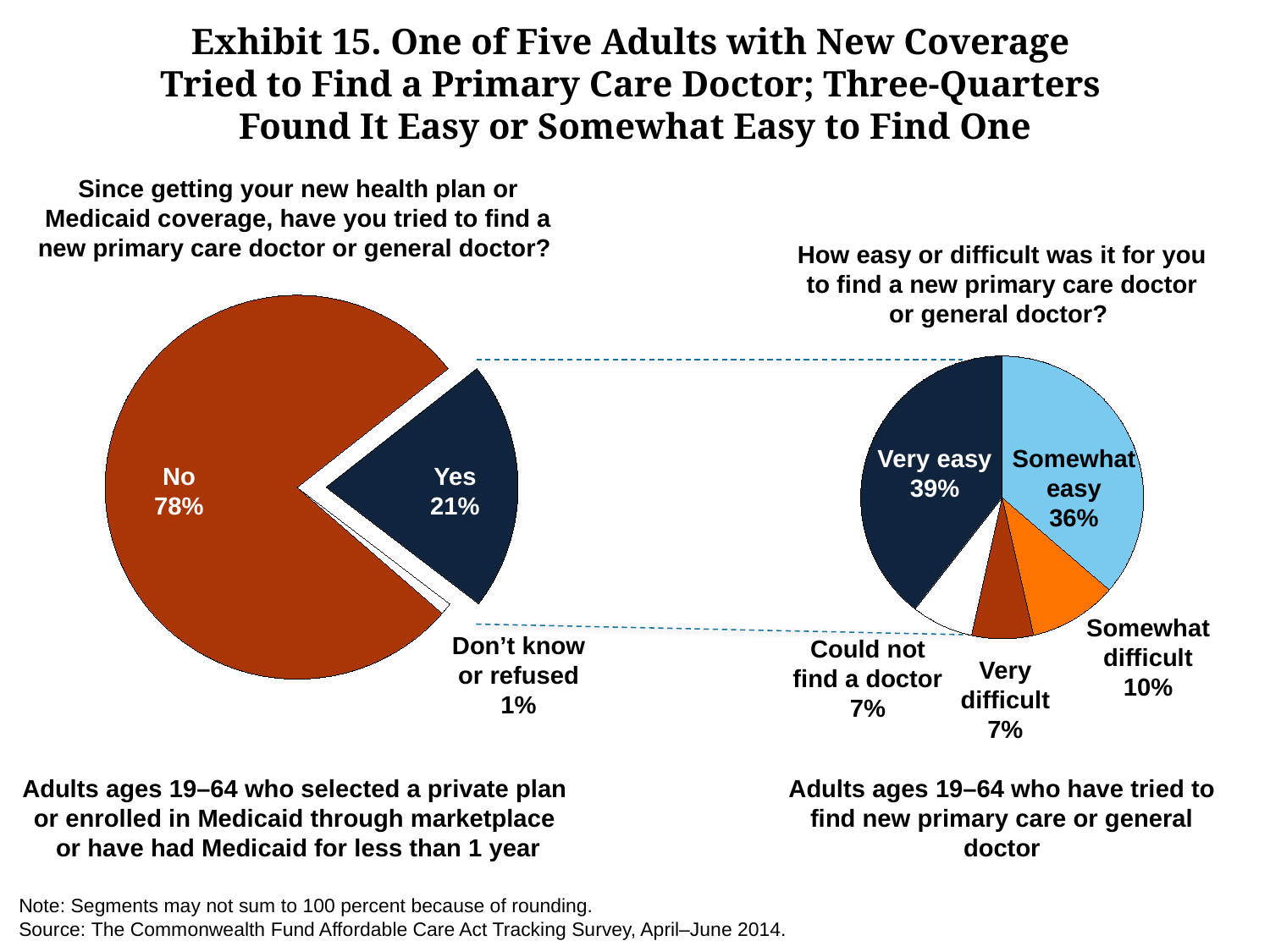
How many segments does the right pie chart have? 5 In the left pie chart, what percentage is labeled "Don't know or refused"? 1% In the right pie chart, which category has the largest share? Very easy In the right pie chart, what percentage found it "Somewhat difficult"? 10% In the right pie chart, what percentage could not find a doctor? 7% In the left pie chart, what percentage answered "Yes"? 21% What type of chart is used on the left side of the slide? Pie chart In the right pie chart, what percentage found it "Very easy" to find a new doctor? 39% In the right pie chart, what is the difference in percentage points between "Very easy" and "Somewhat easy"? 3 In the left pie chart, what is the difference in percentage points between "No" and "Yes"? 57 In the right pie chart, which is larger: "Somewhat difficult" or "Very difficult"? Somewhat difficult In the left pie chart, what percentage of adults answered "No" to having tried to find a new primary care doctor? 78%